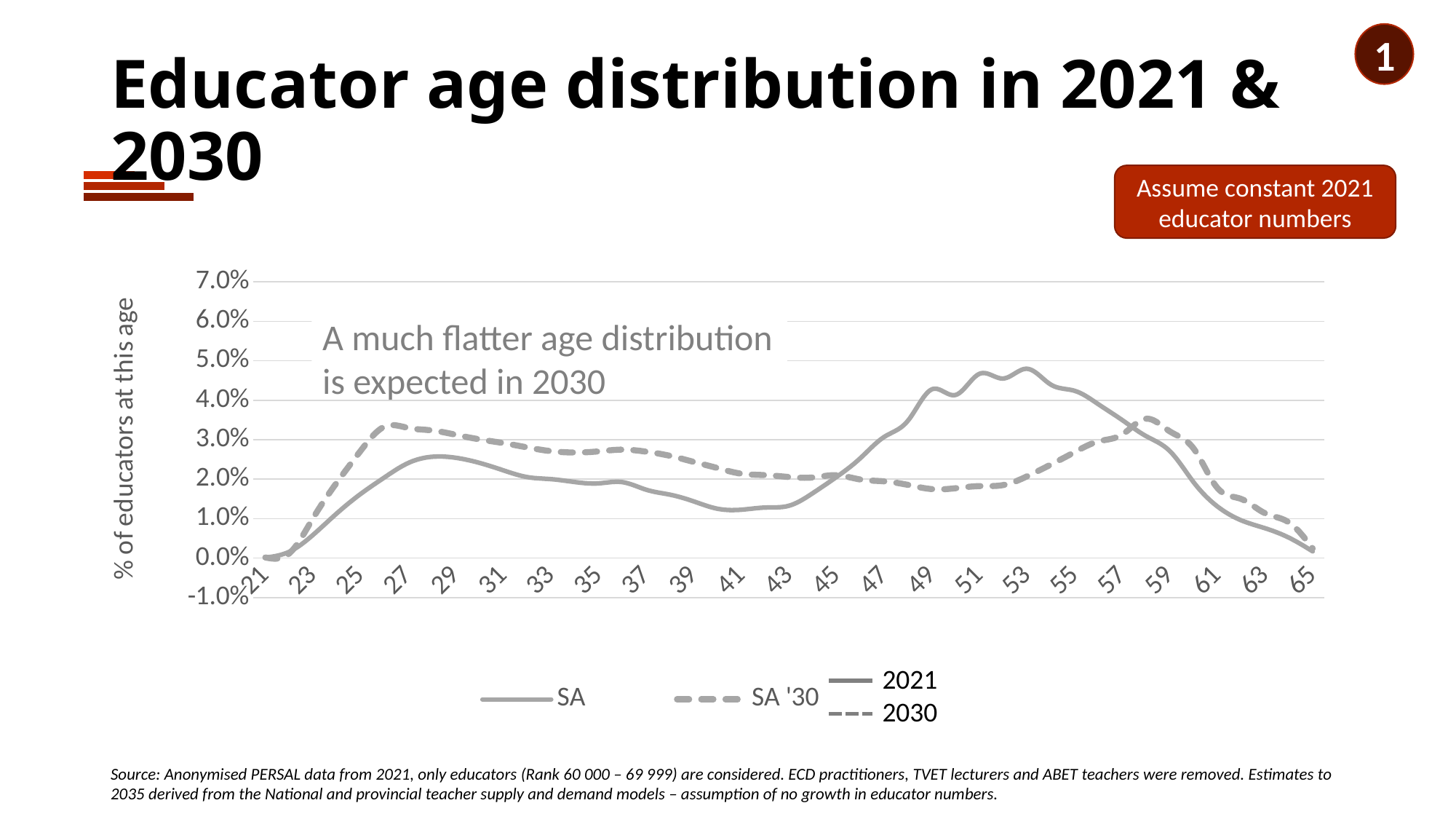
How many series does the chart legend list? 2 What kind of chart is shown on the slide? line chart Which series reaches the higher peak value, SA or SA '30? SA At age 27, which series has the larger value, SA or SA '30? SA '30 Is the value of the SA (2021) series at age 41 greater or less than 2.0%? less Is the value of the SA (2021) series at age 53 greater or less than 4.0%? greater Does the SA (2021) series rise or fall between age 41 and age 53? rise What is the label on the vertical axis of the chart? % of educators at this age Does the SA '30 (2030) series rise or fall between age 27 and age 49? fall At age 53, which series has the larger value, SA or SA '30? SA Is the value of the SA '30 (2030) series at age 53 greater or less than 3.0%? less